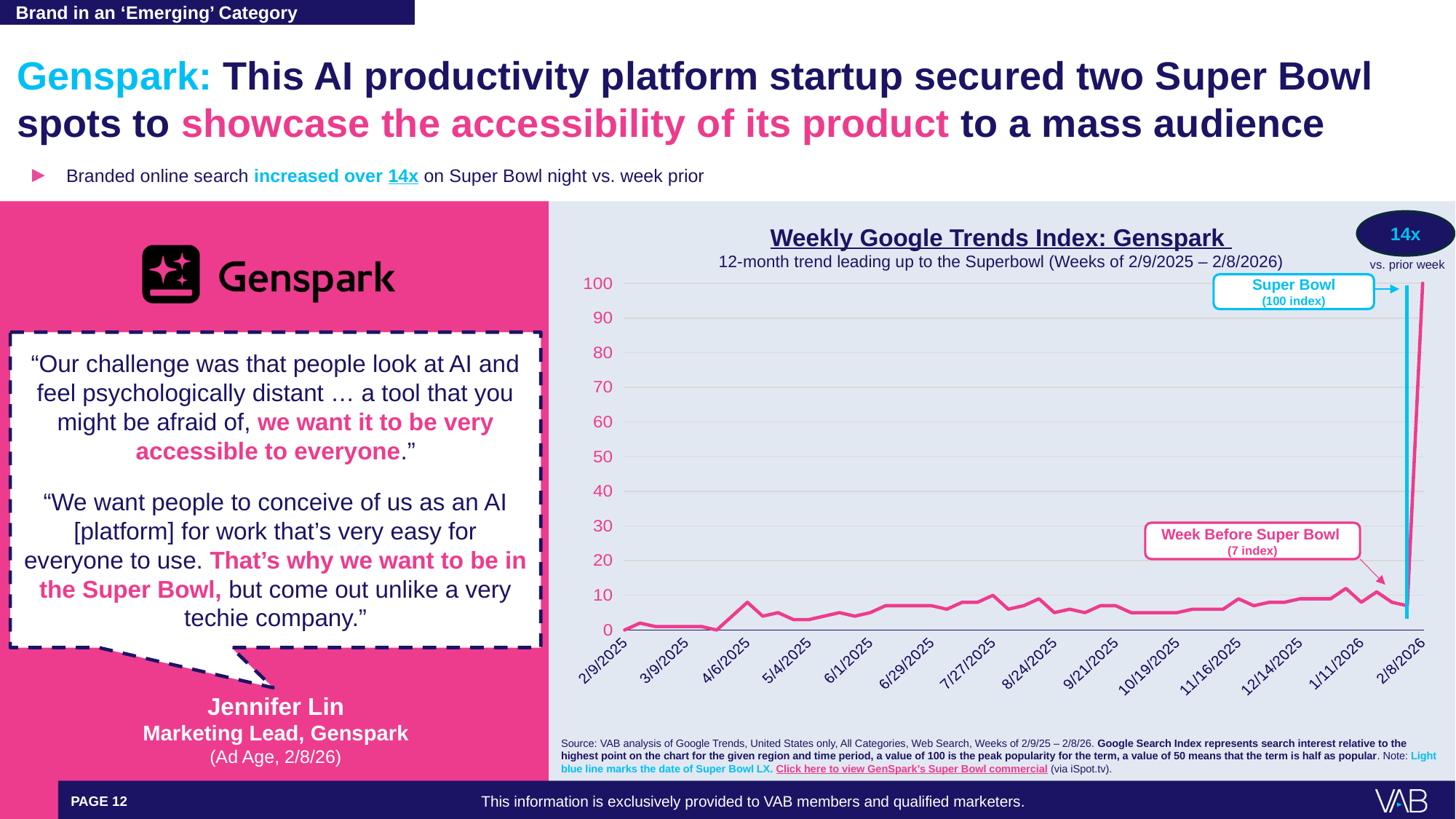
What index value does the chart give for the Super Bowl week? 100 Does the index rise or fall between the week of 1/11/2026 and the week of 2/8/2026? Rise What is the difference between the Super Bowl week index and the week-before-Super-Bowl index? 93 Is the index value for the week of 2/9/2025 greater or less than 10? less What is the title of the chart? Weekly Google Trends Index: Genspark How many date labels are shown on the x axis of the chart? 14 Which is larger: the index for the Super Bowl week or the index for the week before the Super Bowl? Super Bowl week According to the chart's note, what does the light blue vertical line mark? The date of Super Bowl LX What kind of chart is shown on the slide? Line chart Which week has the highest Google Trends index on the chart? Super Bowl week (2/8/2026) What index value does the chart give for the week before the Super Bowl? 7 Is the index value for the week of 7/27/2025 greater or less than 20? less